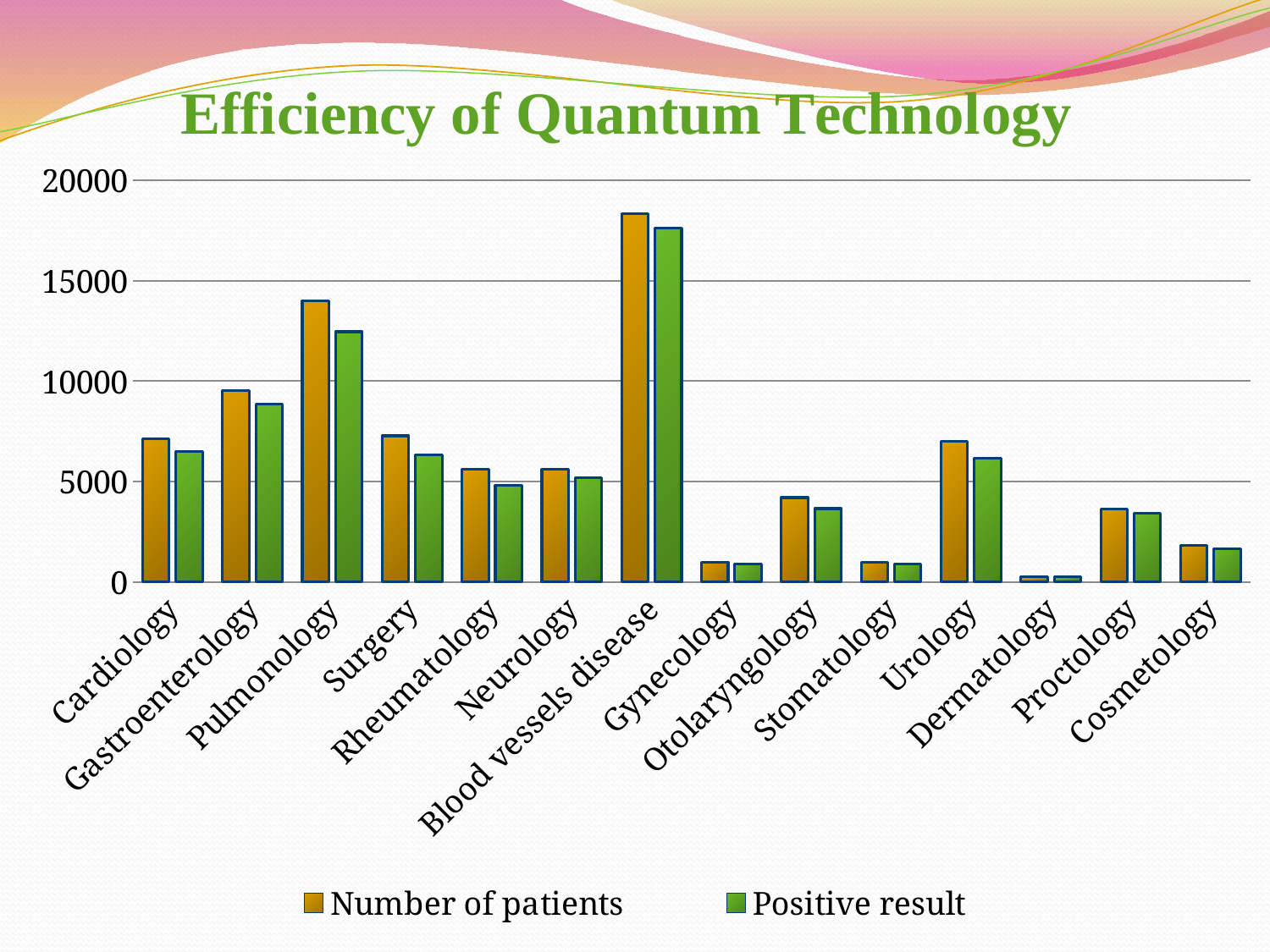
Is the Positive result for Urology greater or less than 5000? greater Which has a larger Positive result, Proctology or Cosmetology? Proctology What type of chart is shown on the slide? Bar chart Is the Number of patients for Pulmonology greater or less than 15000? less How many series does the legend list? 2 Is the Number of patients for Otolaryngology greater or less than 5000? less Which category has the highest Number of patients? Blood vessels disease How many categories are shown on the x axis? 14 Which has a larger Number of patients, Surgery or Neurology? Surgery Which category has the lowest Number of patients? Dermatology What is the title of the chart? Efficiency of Quantum Technology